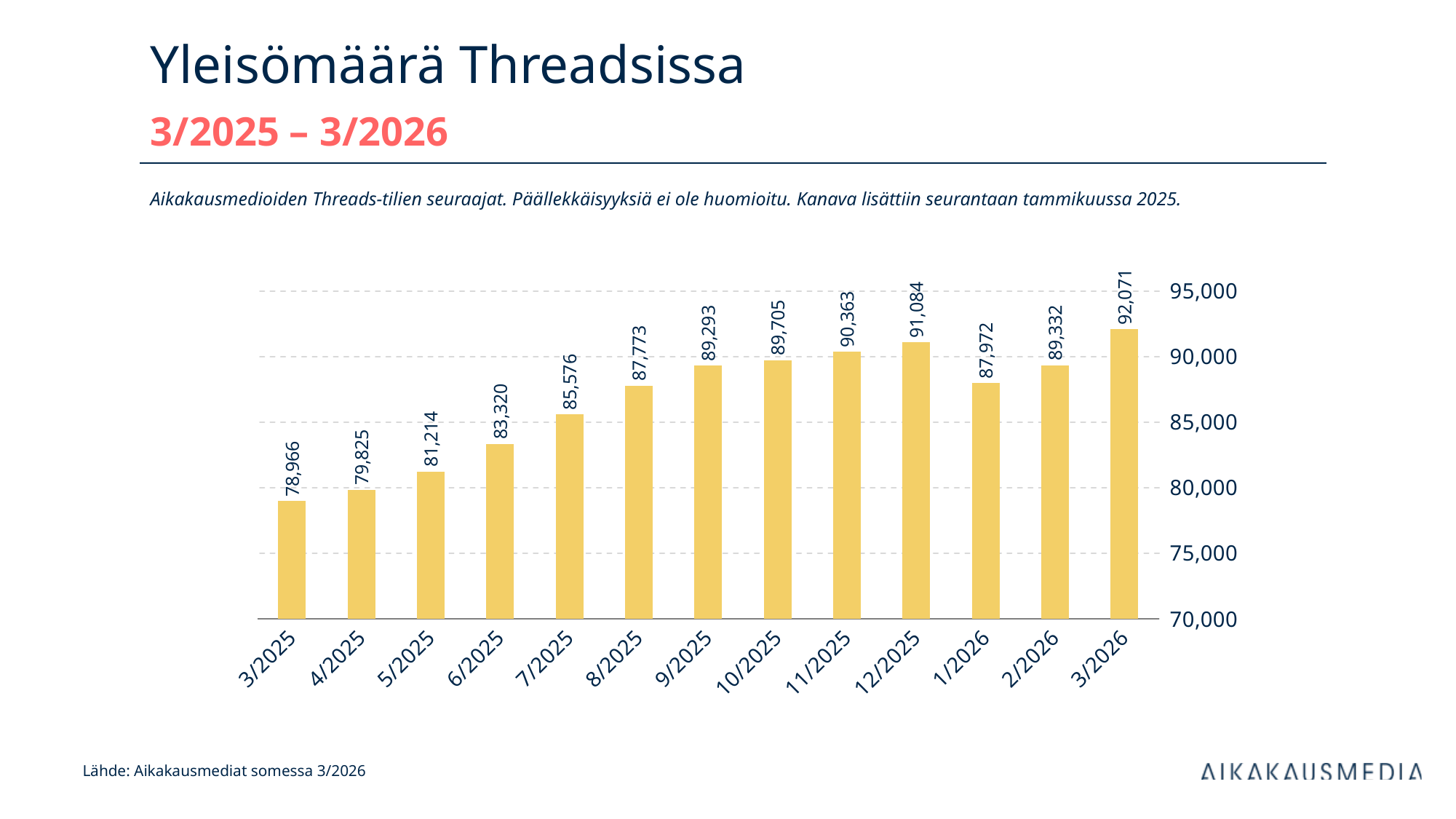
Is the value for 7/2025 greater or less than 85,000? greater Which month has the lowest value? 3/2025 What is the difference between the values for 12/2025 and 1/2026? 3,112 What is the value for 12/2025? 91,084 Which is larger, the value for 2/2026 or the value for 9/2025? 2/2026 How many months are shown on the x axis? 13 What kind of chart is shown on the slide? bar chart What is the value for 3/2025? 78,966 Which month has the highest value? 3/2026 What is the difference between the values for 3/2026 and 3/2025? 13,105 What is the title of the chart on the slide? Yleisömäärä Threadsissa What is the value for 1/2026? 87,972